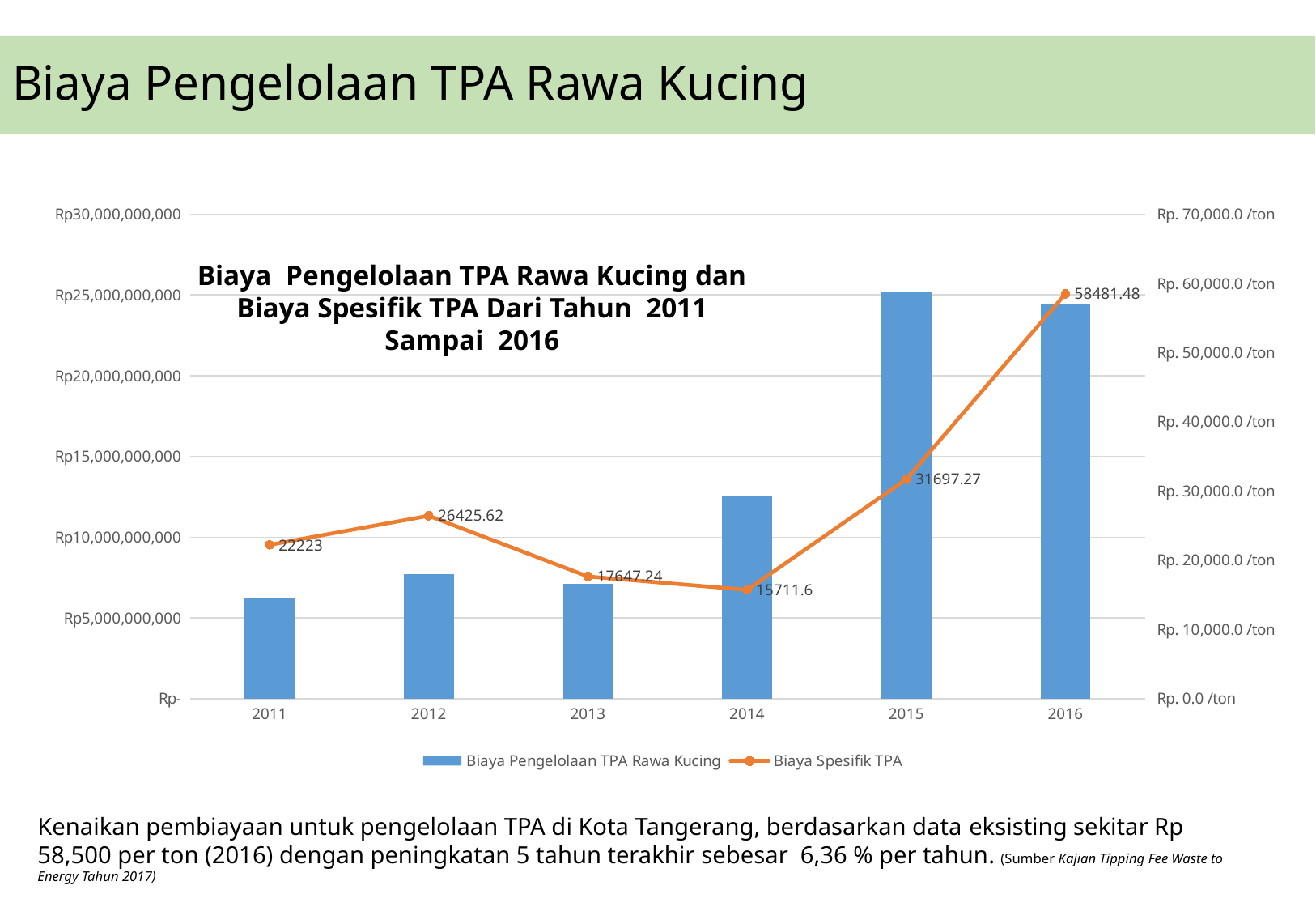
What is the difference between Biaya Spesifik TPA in 2016 and in 2015? 26784.21 In which year is the Biaya Pengelolaan TPA Rawa Kucing bar the lowest? 2011 Is the Biaya Pengelolaan TPA Rawa Kucing bar for 2011 greater or less than Rp10,000,000,000? less Which is larger, Biaya Spesifik TPA in 2012 or in 2013? 2012 How many series does the legend list? 2 What is the value of Biaya Spesifik TPA in 2014? 15711.6 How many years are shown on the x axis of the chart? 6 What is the value of Biaya Spesifik TPA in 2016? 58481.48 In which year is Biaya Spesifik TPA highest? 2016 In which year is Biaya Spesifik TPA lowest? 2014 Is the Biaya Pengelolaan TPA Rawa Kucing bar for 2014 greater or less than Rp10,000,000,000? greater What is the value of Biaya Spesifik TPA in 2011? 22223